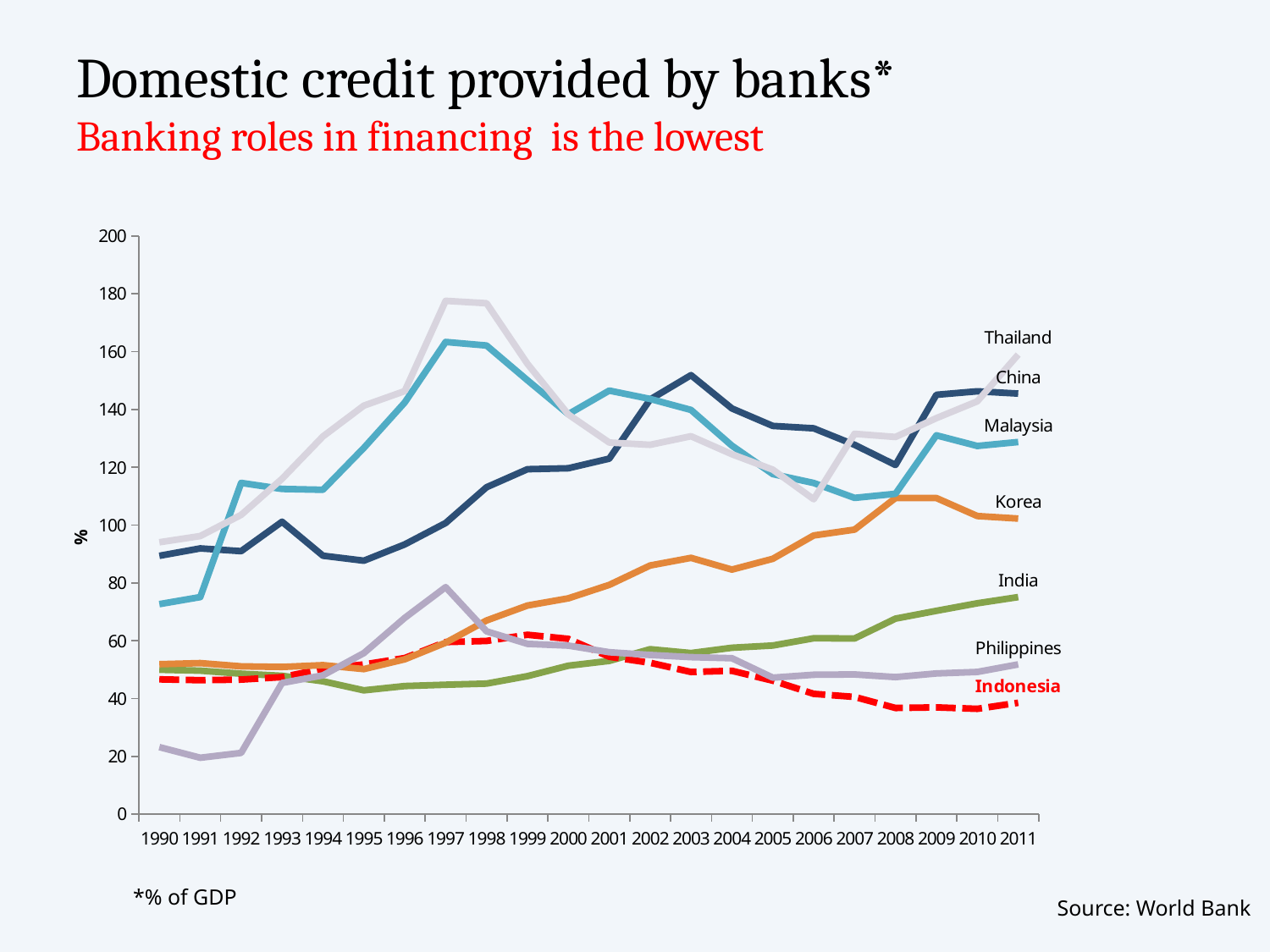
In 1990, which is larger: the value for China or the value for Philippines? China How many years are shown along the x axis? 22 Is the value for Korea in 2011 greater or less than 80? greater Which country has the lowest value in 2011? Indonesia Is the value for China in 2003 greater or less than 140? greater Is the value for Thailand in 1997 greater or less than 160? greater How many countries (series) are plotted on the chart? 7 What kind of chart is shown on the slide? Line chart Which country has the highest value in 2011? Thailand What is the title of the chart? Domestic credit provided by banks* Does the value for India rise or fall from 2005 to 2011? Rise